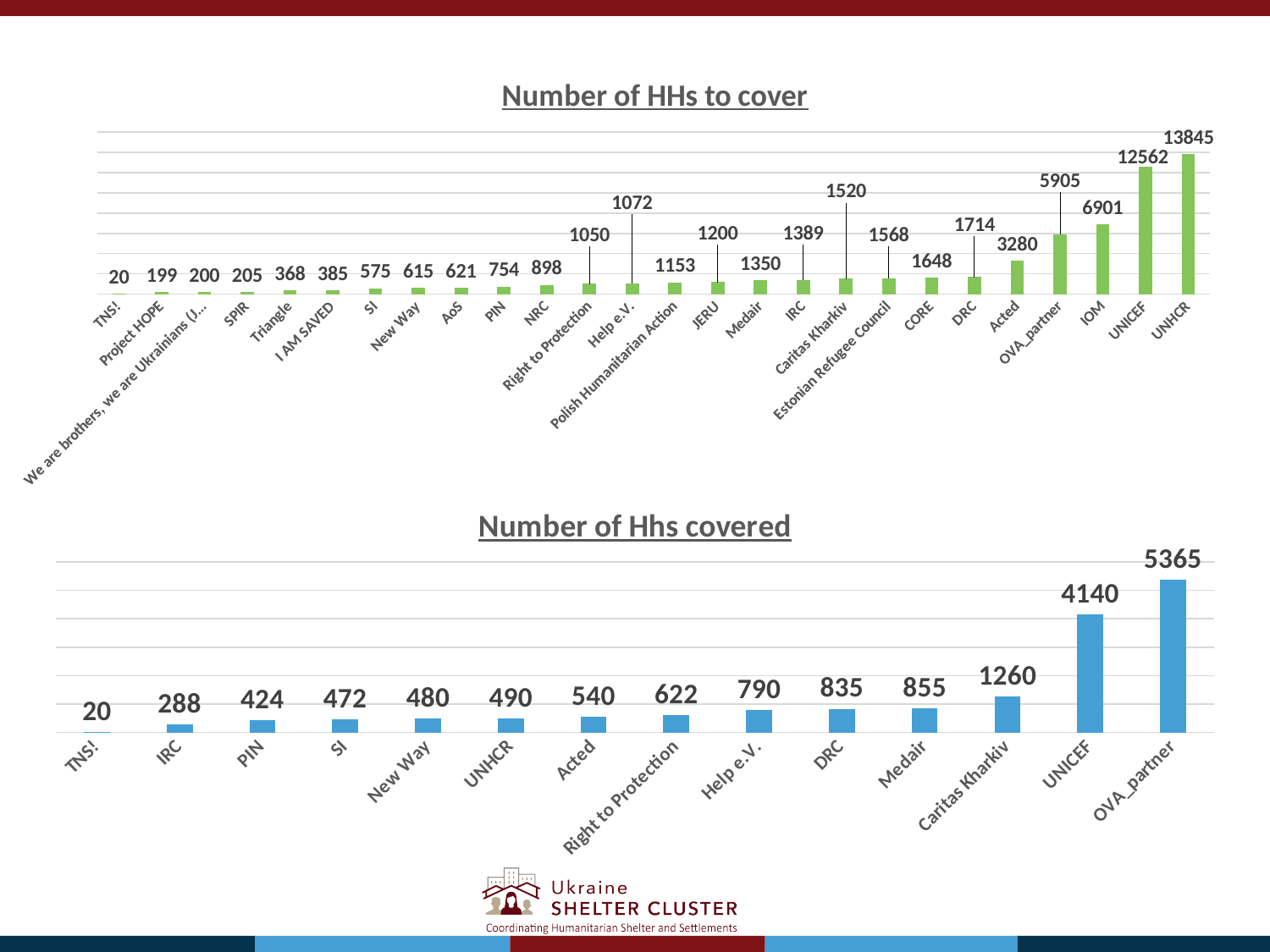
In the 'Number of Hhs covered' chart, which organisation has the highest value? OVA_partner In the 'Number of HHs to cover' chart, do the values rise or fall from left to right? rise In the 'Number of HHs to cover' chart, what is the value for Acted? 3280 In the 'Number of Hhs covered' chart, what is the difference between OVA_partner and UNICEF? 1225 What type of chart is the 'Number of Hhs covered' chart? bar chart In the 'Number of Hhs covered' chart, what is the value for Caritas Kharkiv? 1260 In the 'Number of HHs to cover' chart, which is larger, the value for IOM or the value for OVA_partner? IOM In the 'Number of HHs to cover' chart, which organisation has the lowest value? TNS! How many organisations are shown in the 'Number of Hhs covered' chart? 14 In the 'Number of HHs to cover' chart, what is the difference between UNHCR and UNICEF? 1283 What colour are the bars in the 'Number of HHs to cover' chart? green In the 'Number of HHs to cover' chart, what is the value for UNHCR? 13845